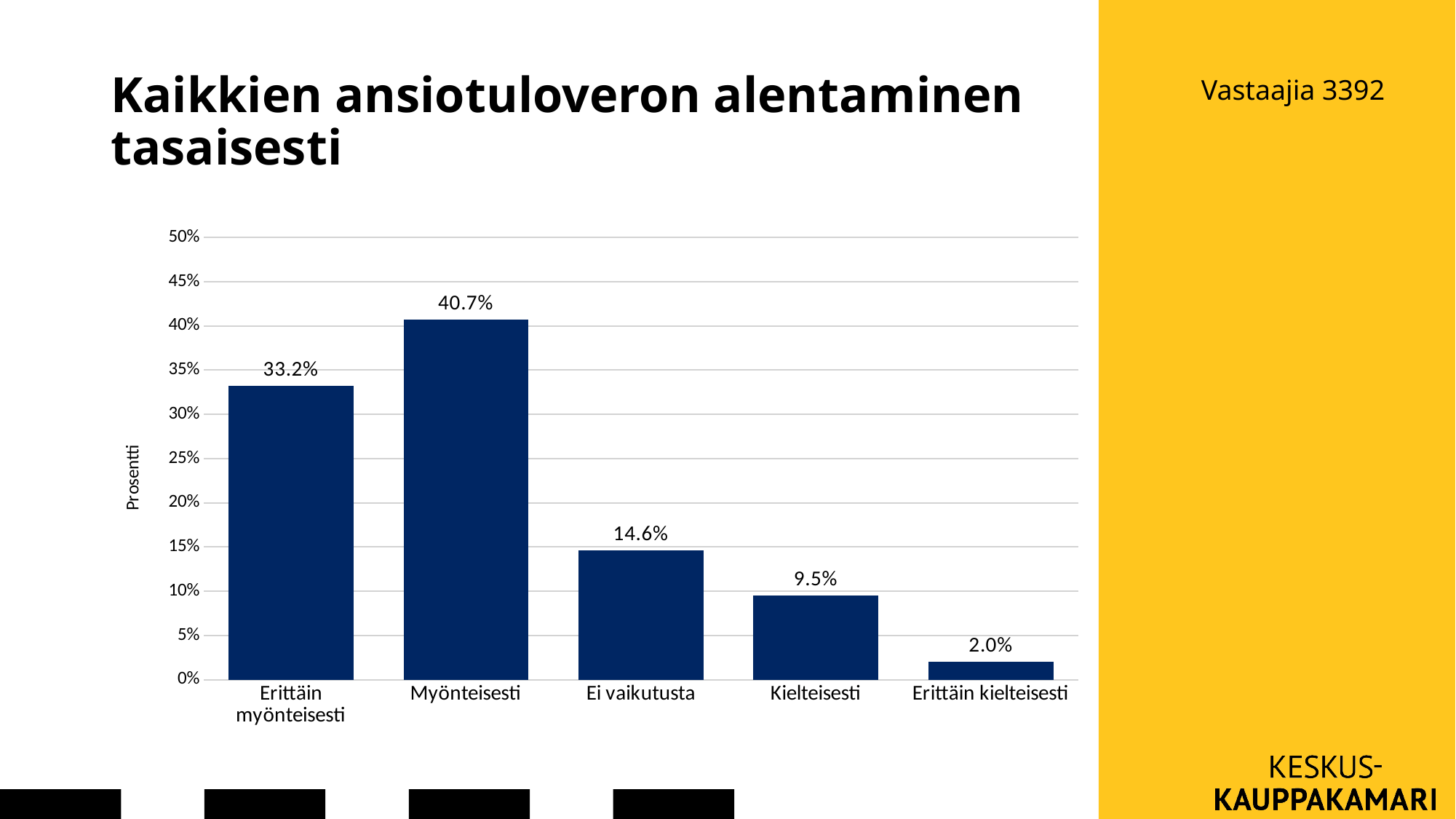
Which category has the highest value? Myönteisesti What is the value for Erittäin kielteisesti? 2.0% What is the difference between the values for Myönteisesti and Erittäin myönteisesti? 7.5% How many categories are shown on the x axis? 5 What is the label of the vertical axis? Prosentti Which is larger, the value for Ei vaikutusta or the value for Kielteisesti? Ei vaikutusta What kind of chart is shown on the slide? bar chart What is the value for Erittäin myönteisesti? 33.2% Which category has the lowest value? Erittäin kielteisesti What is the value for Myönteisesti? 40.7% Is the value for Kielteisesti greater or less than 10%? less What is the value for Ei vaikutusta? 14.6%